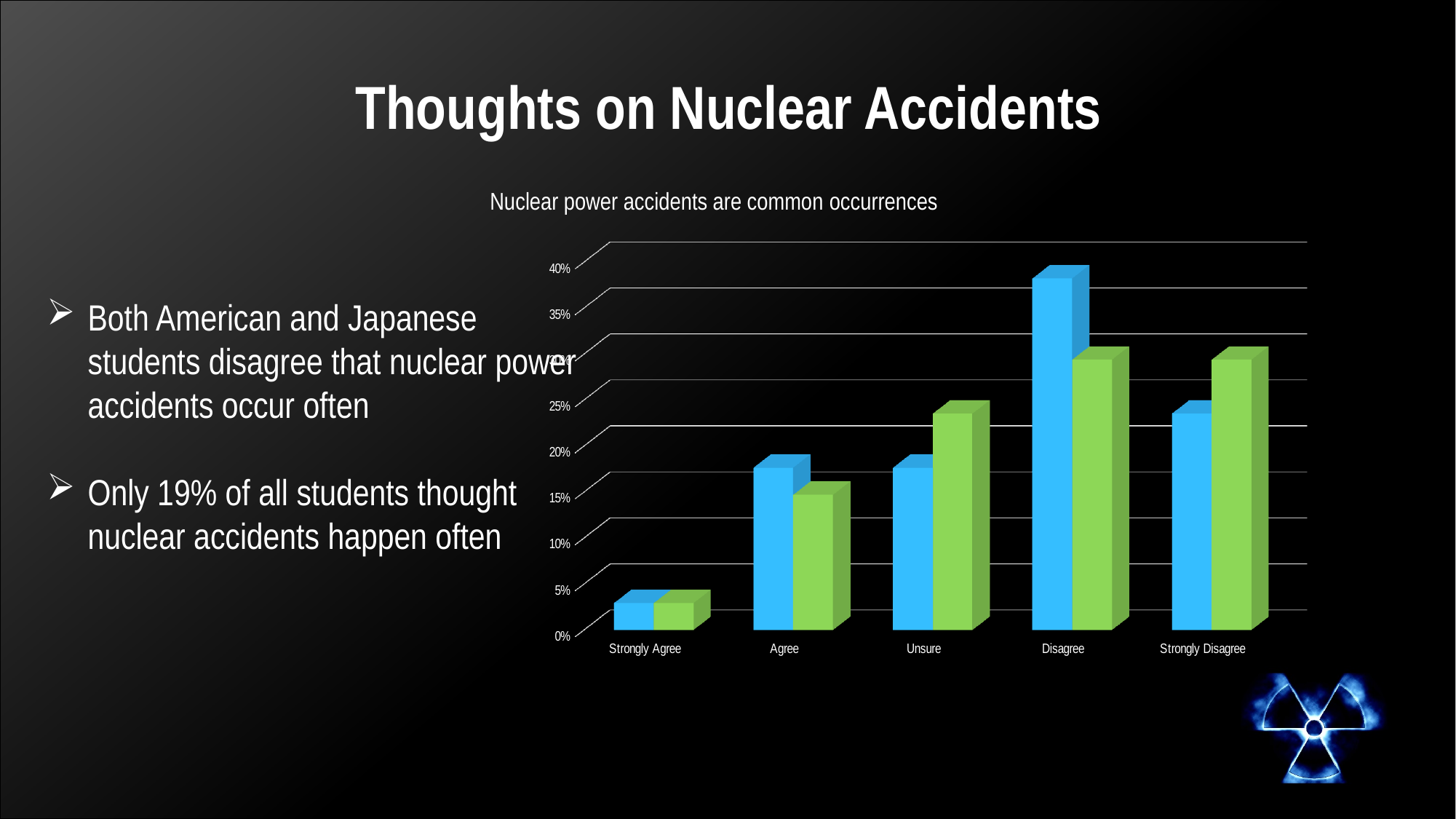
Is the green bar for Unsure greater or less than 20%? greater Which category has the shortest blue bar in the chart? Strongly Agree For the Unsure category, which bar is taller, the blue one or the green one? green For the Disagree category, which bar is taller, the blue one or the green one? blue Is the blue bar for Disagree greater or less than 35%? greater Which category has the shortest green bar in the chart? Strongly Agree Is the blue bar for Strongly Agree greater or less than 5%? less What is the title of the chart? Nuclear power accidents are common occurrences How many response categories are shown on the x axis of the chart? 5 Which category has the tallest blue bar in the chart? Disagree What kind of chart is shown on the slide? bar chart